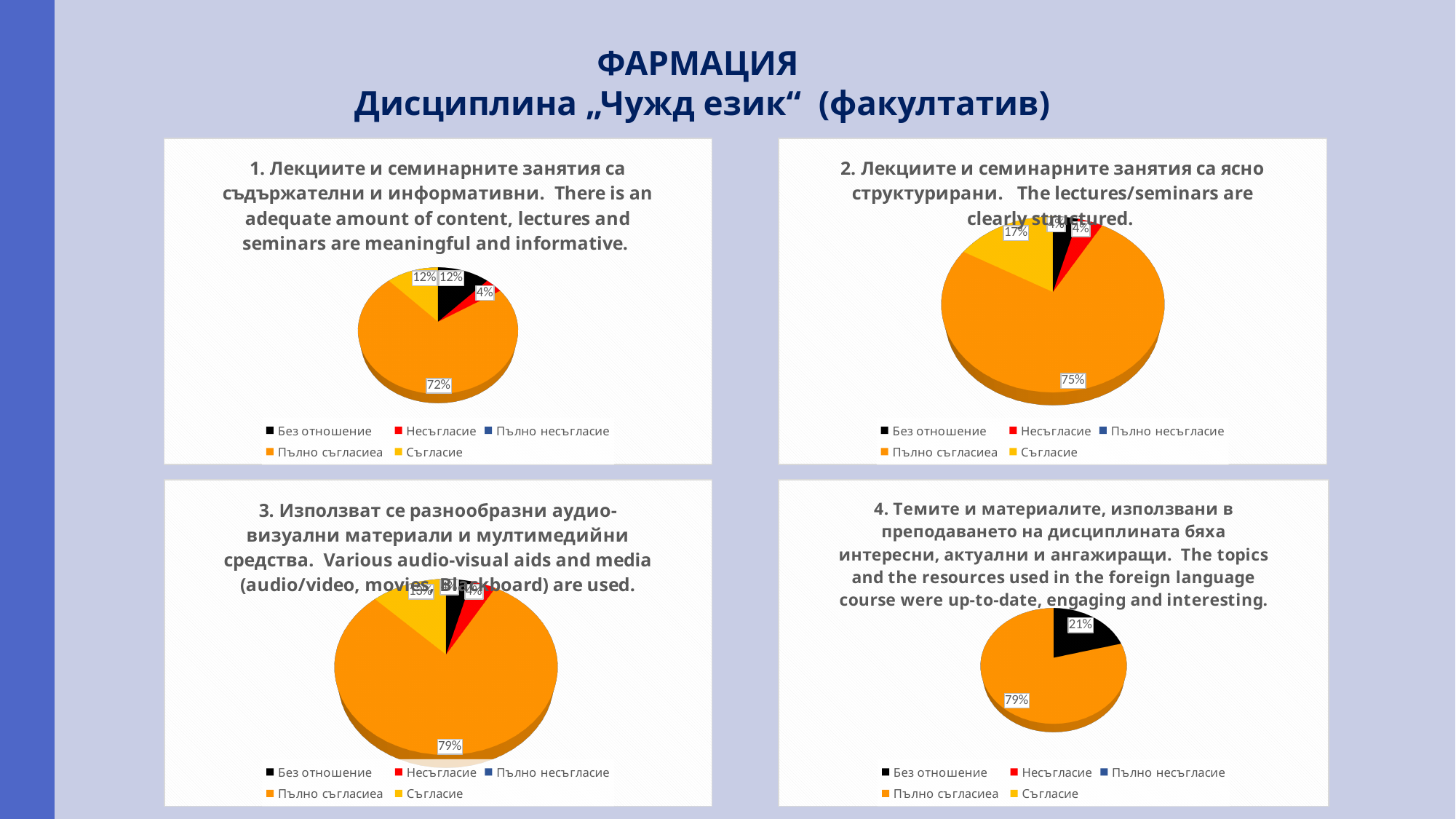
In the bottom-right chart (question 4), which is larger: the Без отношение slice or the Пълно съгласие slice? Пълно съгласие What type of chart is used for question 4 in the bottom-right? Pie chart In the bottom-left chart (question 3), what percentage is shown for Пълно съгласие (the orange slice)? 79% In the top-left chart (question 1), what percentage is shown for Несъгласие (the red slice)? 4% In the top-right chart (question 2), what is the difference between the Пълно съгласие slice and the Съгласие slice? 58% In the top-left chart (question 1), what percentage is shown for Пълно съгласие (the orange slice)? 72% In the top-right chart (question 2), what percentage is shown for Съгласие (the yellow slice)? 17% In the top-left chart (question 1), which category has the largest slice? Пълно съгласие In the top-right chart (question 2), what percentage is shown for Пълно съгласие (the orange slice)? 75% How many entries does the legend of the top-left chart (question 1) list? 5 In the bottom-right chart (question 4), what is the difference between the Пълно съгласие slice and the Без отношение slice? 58% In the bottom-right chart (question 4), what percentage is shown for Без отношение (the black slice)? 21%